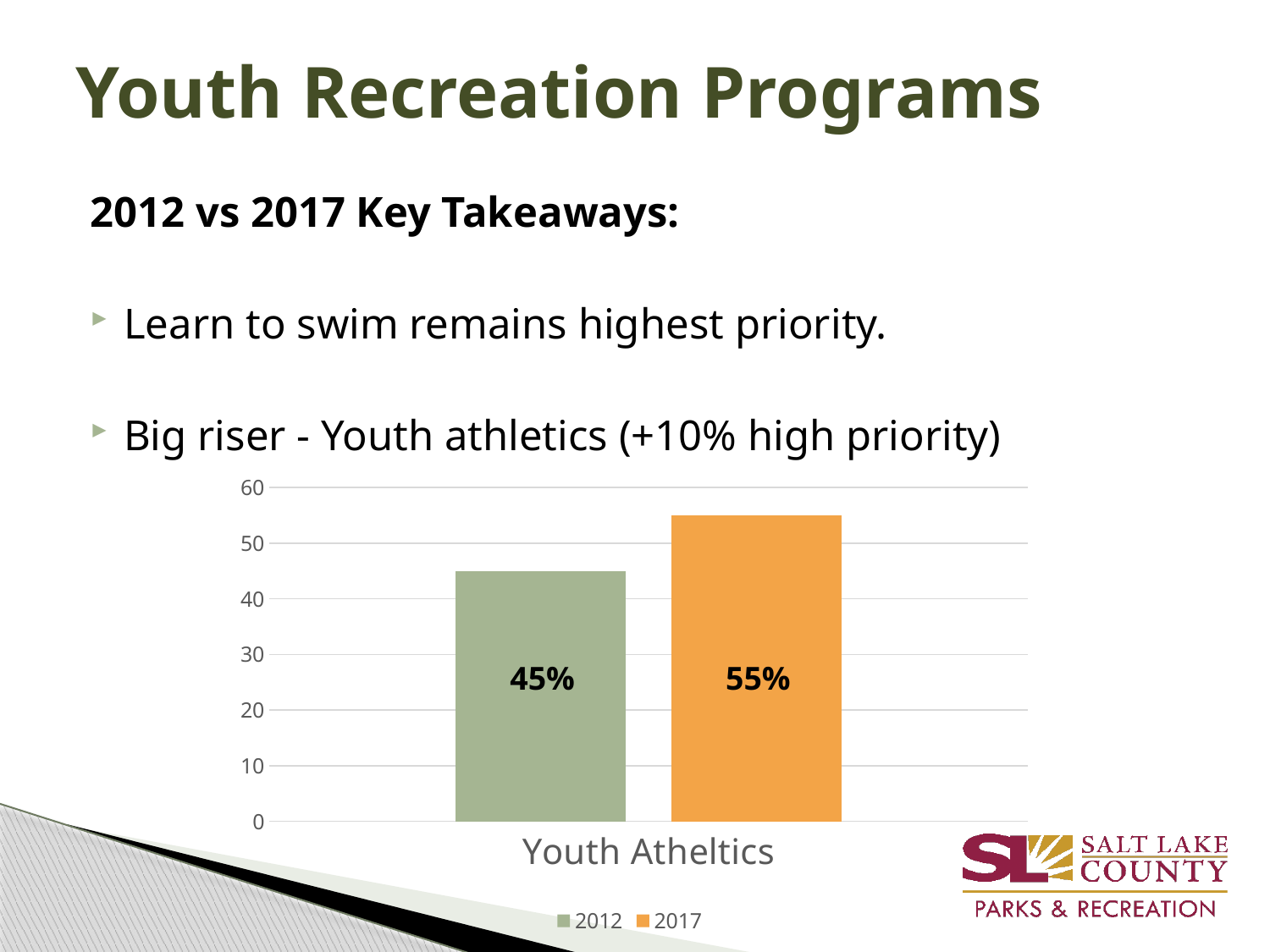
What kind of chart is shown on the slide? bar chart Which series has the lowest value in the chart? 2012 What is the difference between the 2017 and 2012 values for Youth Athletics? 10% Is the value for 2017 greater or less than 50? greater What is the category label on the x axis? Youth Atheltics What is the value for 2017 for Youth Athletics? 55% What is the value for 2012 for Youth Athletics? 45% How many categories are shown on the x axis? 1 Is the value for 2012 greater or less than 50? less Which series is shown in orange? 2017 How many series does the legend list? 2 Which series has the higher value for Youth Athletics, 2012 or 2017? 2017